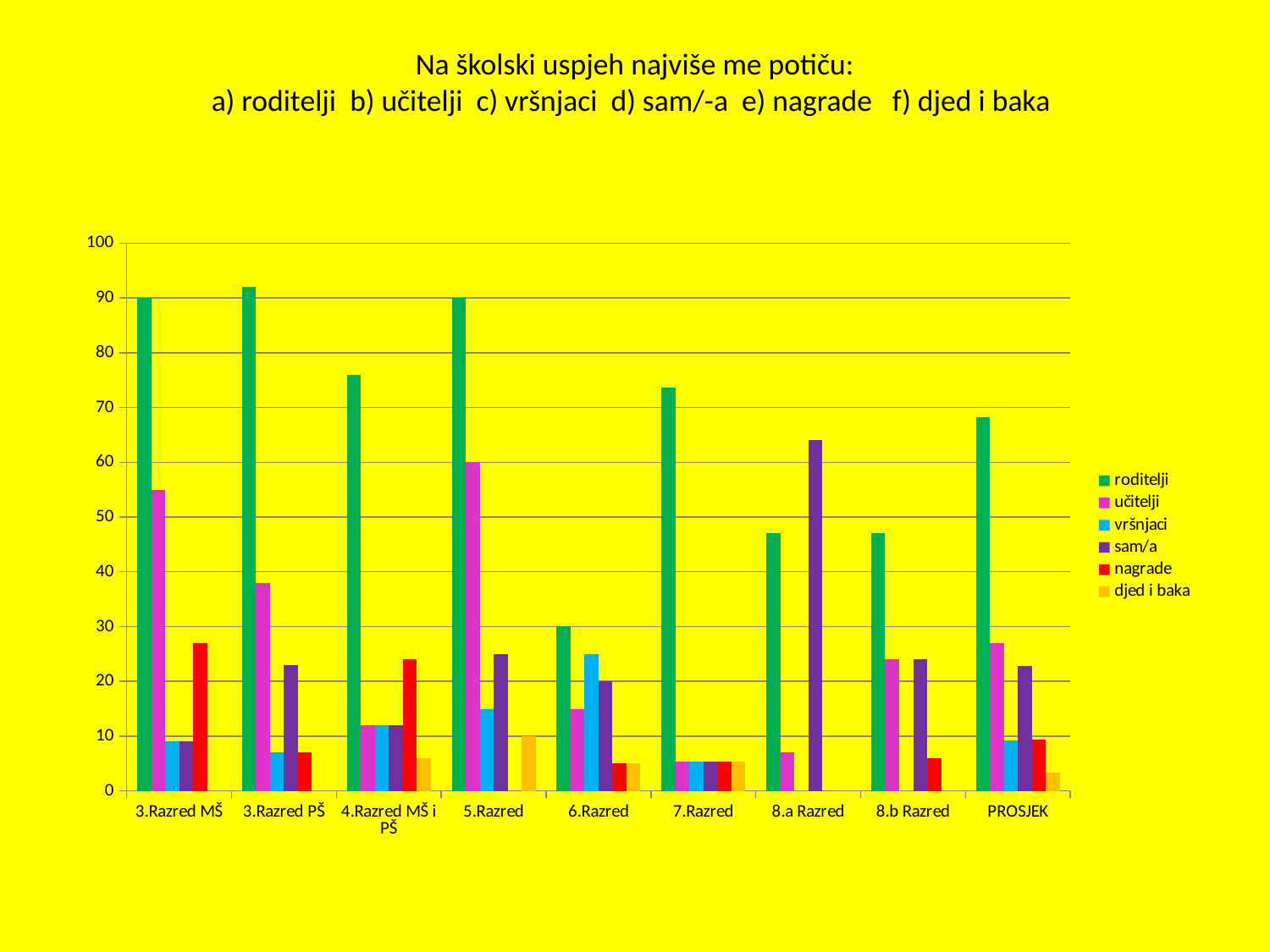
Which category has the lowest value for roditelji? 6.Razred What kind of chart is shown on the slide? bar chart How many series does the legend list? 6 In the 8.a Razred category, which series has the highest bar? sam/a Is the value for učitelji in 5.Razred greater or less than 50? greater Which category has the highest value for sam/a? 8.a Razred In the 6.Razred category, which is larger: vršnjaci or učitelji? vršnjaci Which has the larger value for učitelji: 3.Razred MŠ or 3.Razred PŠ? 3.Razred MŠ What colour represents the roditelji series in the legend? green How many categories are shown along the x axis? 9 Is the value for sam/a in 8.a Razred greater or less than 60? greater Is the value for roditelji in 4.Razred MŠ i PŠ greater or less than 70? greater